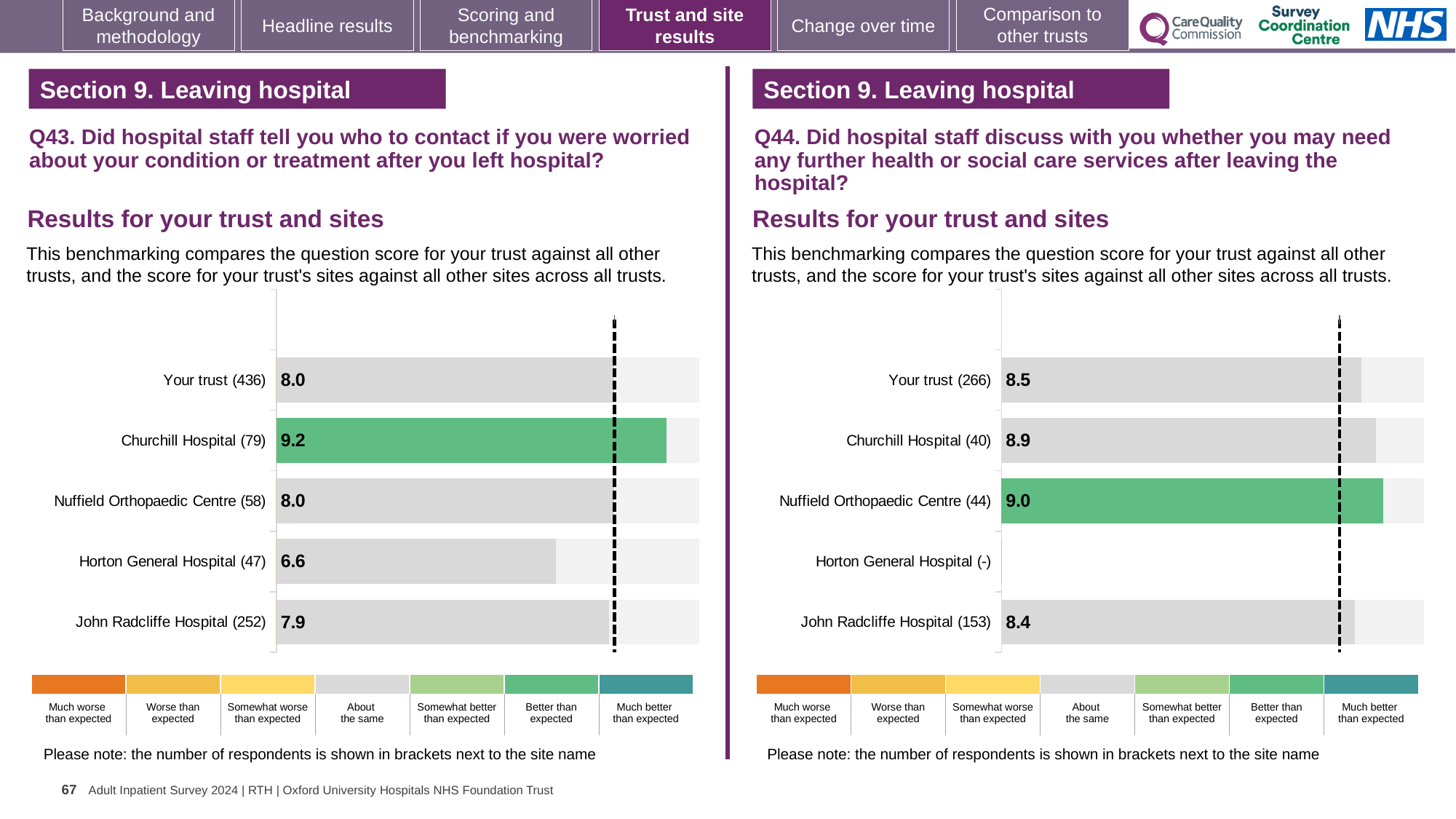
In the Q44 chart on the right, which is larger, the score for Churchill Hospital or John Radcliffe Hospital? Churchill Hospital In the Q43 chart on the left, how many respondents are shown for Your trust? 436 In the Q43 chart on the left, which site has the highest score? Churchill Hospital In the Q43 chart on the left, what is the difference between the scores for Churchill Hospital and John Radcliffe Hospital? 1.3 In the Q43 chart on the left, which site has the lowest score? Horton General Hospital What kind of chart is used on the left for Q43? Bar chart In the Q44 chart on the right, what is the score for Nuffield Orthopaedic Centre? 9.0 In the Q44 chart on the right, what is the difference between the scores for Nuffield Orthopaedic Centre and John Radcliffe Hospital? 0.6 In the Q44 chart on the right, which site has the highest score? Nuffield Orthopaedic Centre In the Q43 chart on the left, what is the score for Churchill Hospital? 9.2 In the Q43 chart on the left, what is the score for Horton General Hospital? 6.6 In the Q44 chart on the right, what is the score for Your trust? 8.5